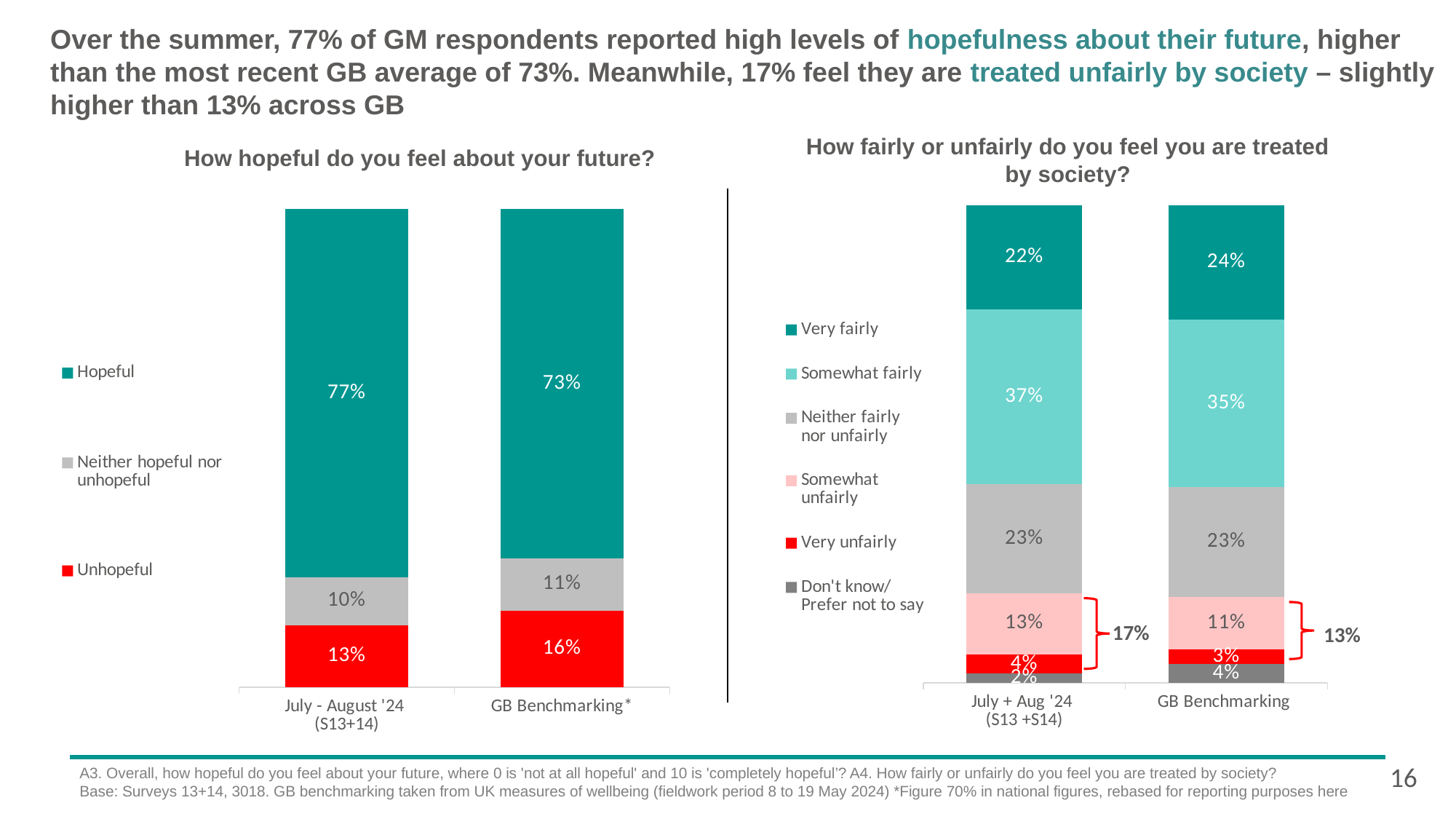
In the 'How hopeful do you feel about your future?' chart, what is the difference between the Hopeful values for July - August '24 (S13+14) and GB Benchmarking? 4 percentage points How many series does the legend of the 'How fairly or unfairly do you feel you are treated by society?' chart list? 6 How many series does the legend of the 'How hopeful do you feel about your future?' chart list? 3 In the 'How fairly or unfairly do you feel you are treated by society?' chart, what is the Don't know/Prefer not to say value for GB Benchmarking? 4% In the 'How fairly or unfairly do you feel you are treated by society?' chart, what is the combined Somewhat unfairly and Very unfairly share shown by the bracket for July + Aug '24 (S13 +S14)? 17% In the 'How fairly or unfairly do you feel you are treated by society?' chart, what is the Very fairly value for GB Benchmarking? 24% In the 'How hopeful do you feel about your future?' chart, what is the Unhopeful value for GB Benchmarking? 16% In the 'How fairly or unfairly do you feel you are treated by society?' chart, what is the Somewhat fairly value for July + Aug '24 (S13 +S14)? 37% In the 'How hopeful do you feel about your future?' chart, which bar has the larger 'Neither hopeful nor unhopeful' value, July - August '24 (S13+14) or GB Benchmarking? GB Benchmarking In the 'How hopeful do you feel about your future?' chart, what percentage of July - August '24 (S13+14) respondents were Hopeful? 77% What type of chart is the 'How hopeful do you feel about your future?' chart? Stacked bar chart In the 'How fairly or unfairly do you feel you are treated by society?' chart, which segment is the largest in the July + Aug '24 (S13 +S14) bar? Somewhat fairly